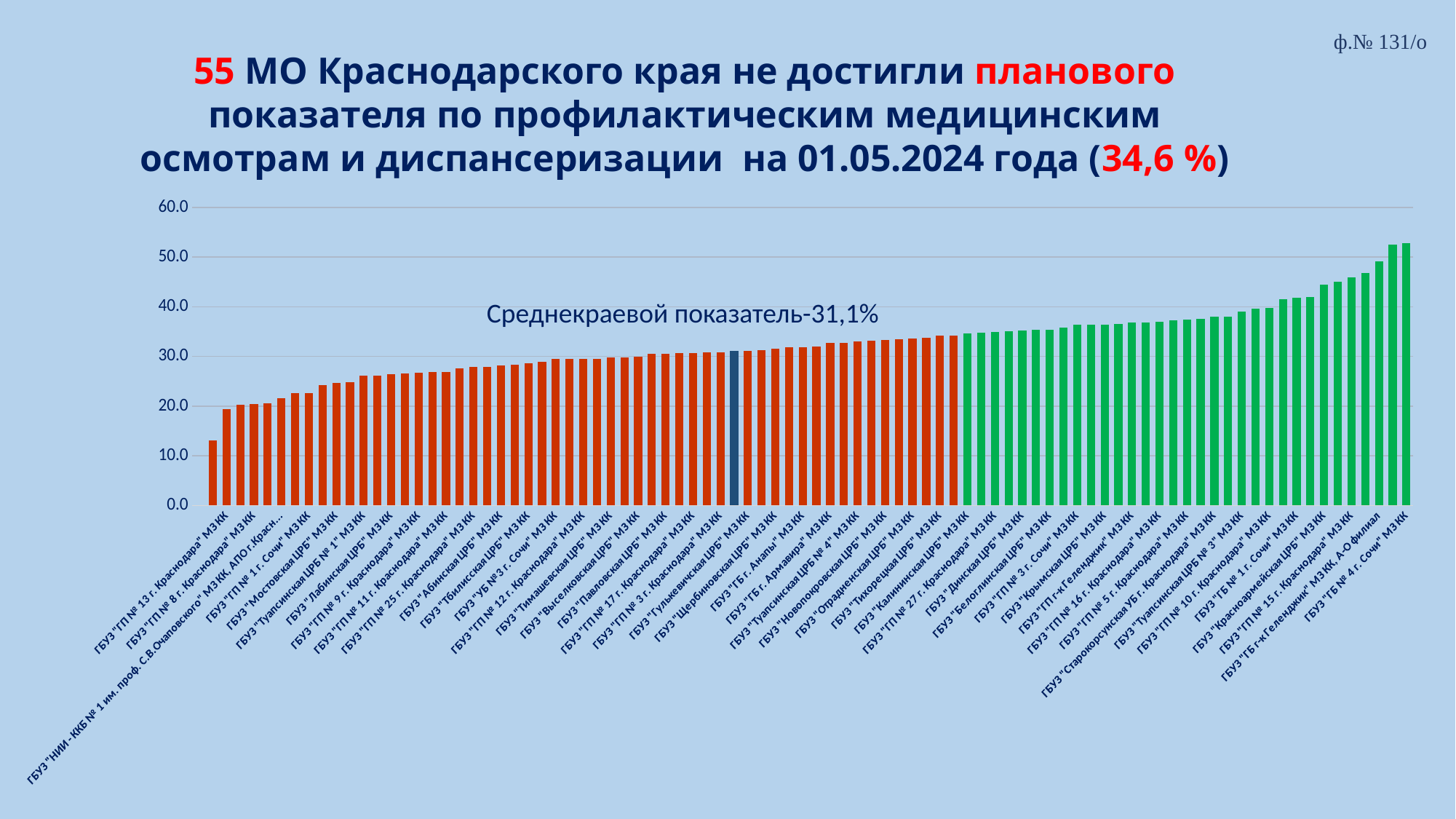
Is the value for ГБУЗ "ГБ № 4 г. Сочи" МЗКК greater or less than 50? greater What kind of chart is shown on the slide? bar chart Which category has the highest bar on the chart? ГБУЗ "ГБ № 4 г. Сочи" МЗКК Which is larger, the value for ГБУЗ "ГП № 13 г. Краснодара" МЗКК or for ГБУЗ "ГБ № 4 г. Сочи" МЗКК? ГБУЗ "ГБ № 4 г. Сочи" МЗКК What is the highest value shown on the vertical axis of the chart? 60.0 Do the bar values rise or fall from left to right along the x axis? rise What is the regional average value (среднекраевой показатель) printed on the chart? 31,1%